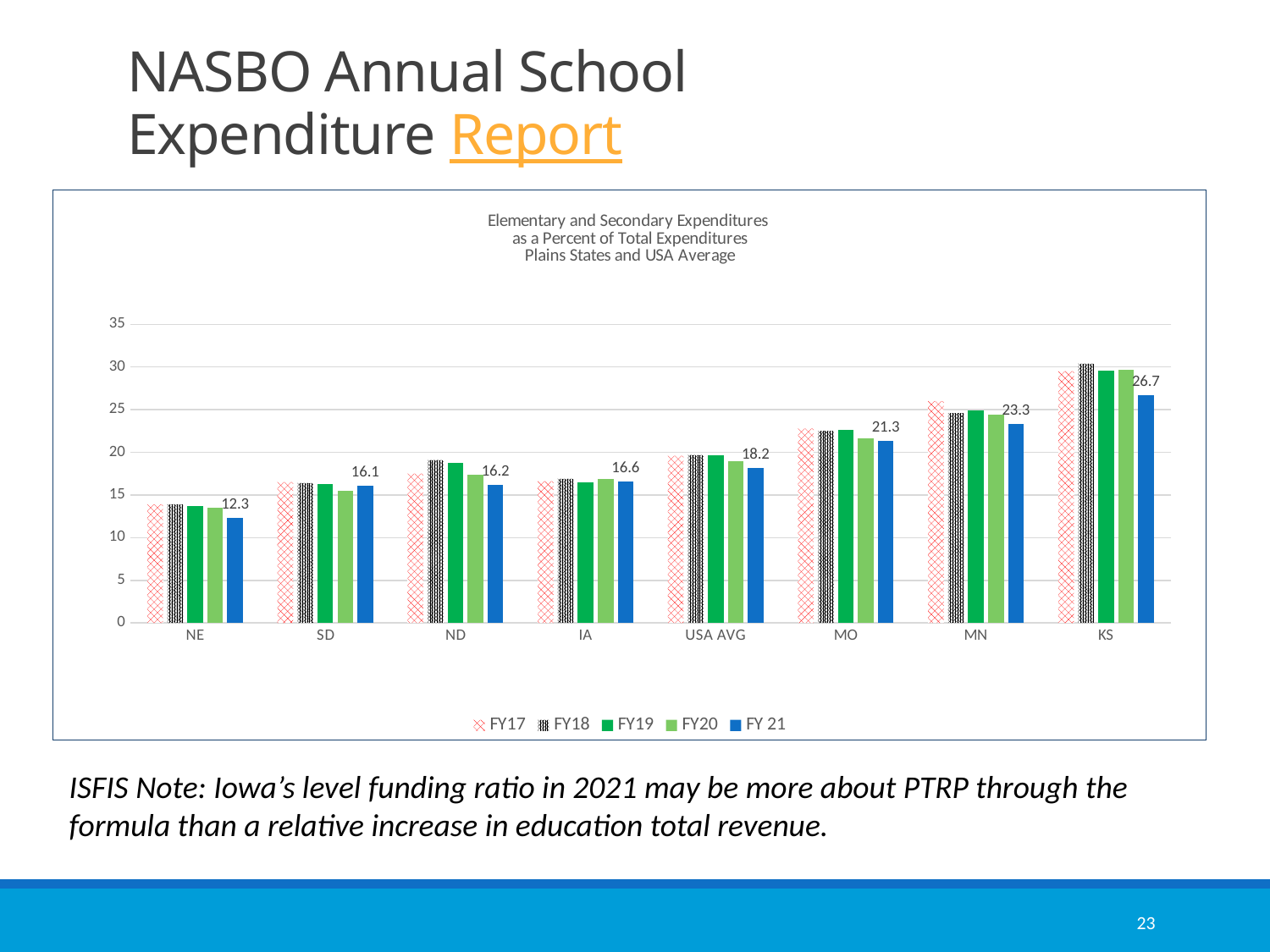
What kind of chart is shown on the slide? Bar chart Is the FY17 value for KS greater or less than 25? greater Is the FY18 value for NE greater or less than 15? less How many categories are shown on the x axis? 8 What is the FY 21 value for NE? 12.3 What is the FY 21 value for USA AVG? 18.2 How many series does the legend list? 5 What is the FY 21 value for KS? 26.7 Which has the larger FY 21 value, MO or MN? MN What is the difference between the FY 21 values for KS and NE? 14.4 Which category has the lowest FY 21 value? NE Which category has the highest FY 21 value? KS